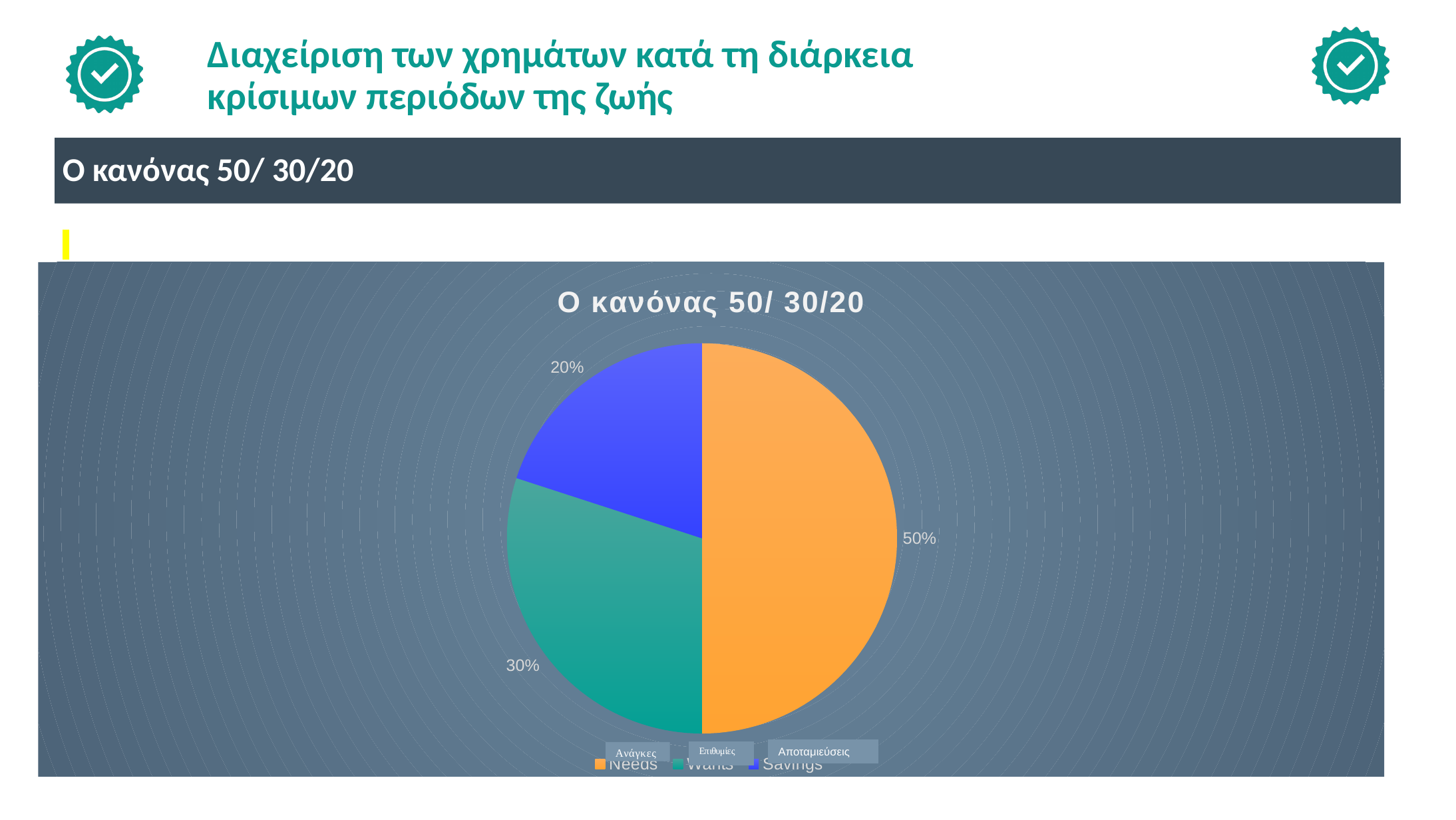
How many slices does the pie chart have? 3 Which slice of the pie is the smallest? Αποταμιεύσεις (Savings) What percentage of the pie does the Ανάγκες (Needs) slice represent? 50% Which slice of the pie is the largest? Ανάγκες (Needs) What is the combined share of the Επιθυμίες (Wants) and Αποταμιεύσεις (Savings) slices? 50% What is the difference in percentage points between the Ανάγκες (Needs) slice and the Αποταμιεύσεις (Savings) slice? 30 percentage points What percentage of the pie does the Επιθυμίες (Wants) slice represent? 30% What percentage of the pie does the Αποταμιεύσεις (Savings) slice represent? 20% Which is larger, the Επιθυμίες (Wants) slice or the Αποταμιεύσεις (Savings) slice? Επιθυμίες (Wants) What is the title of the chart? Ο κανόνας 50/ 30/20 What colour is the Ανάγκες (Needs) slice in the pie chart? Orange What kind of chart is shown on the slide? Pie chart